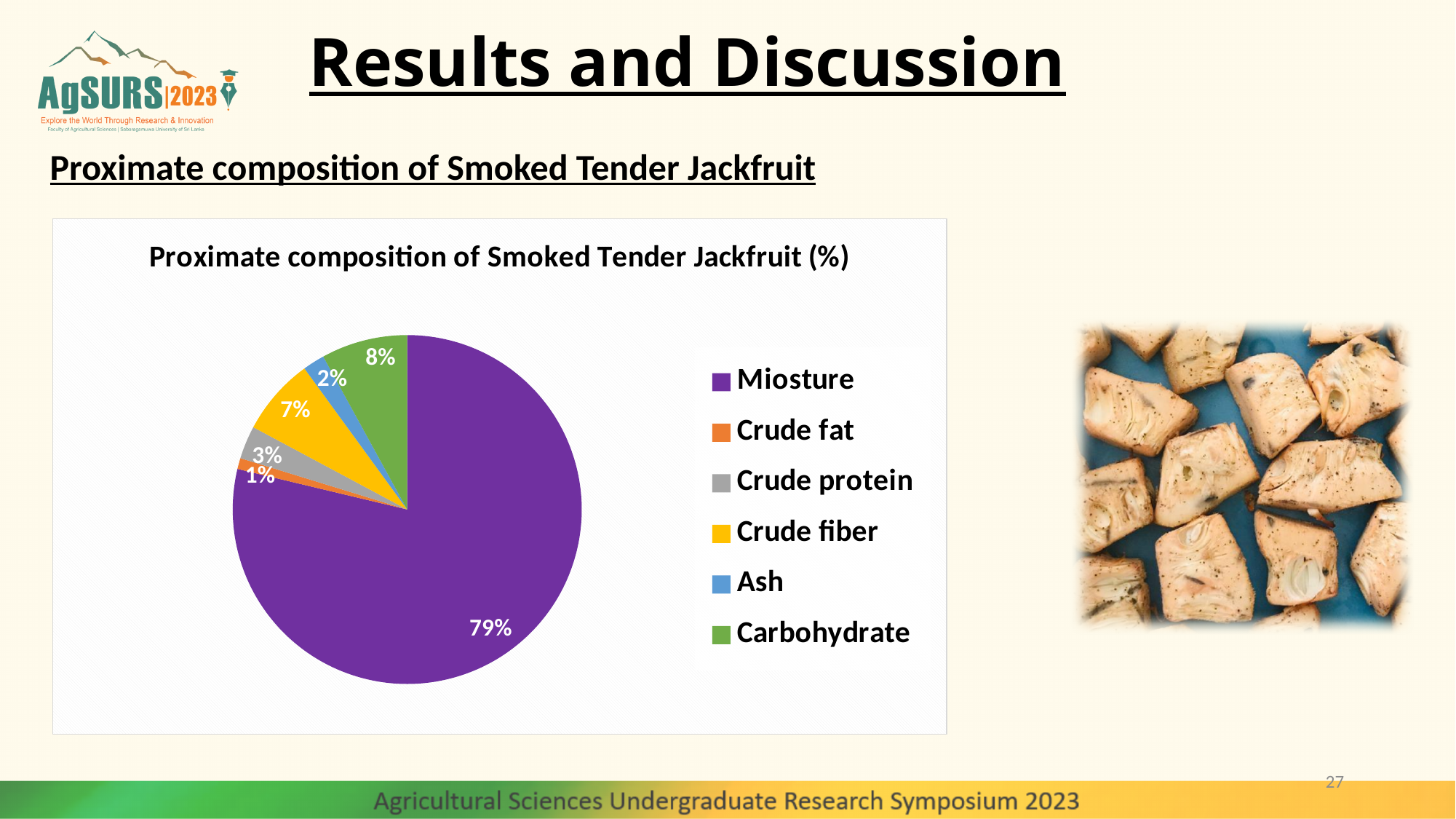
How many components are shown in the pie chart? 6 What is the difference in percentage points between Carbohydrate and Crude fiber? 1 Which component has the largest share of the pie chart? Miosture (moisture) What percentage of the pie chart is Crude protein? 3% What percentage of the pie chart is Carbohydrate? 8% Which is larger, the share for Crude protein or the share for Ash? Crude protein What percentage of the pie chart is Ash? 2% What percentage of the pie chart is Crude fiber? 7% What type of chart is shown on the slide? Pie chart What percentage of the pie chart is Miosture (moisture)? 79% Which component has the smallest share of the pie chart? Crude fat What is the title of the chart? Proximate composition of Smoked Tender Jackfruit (%)